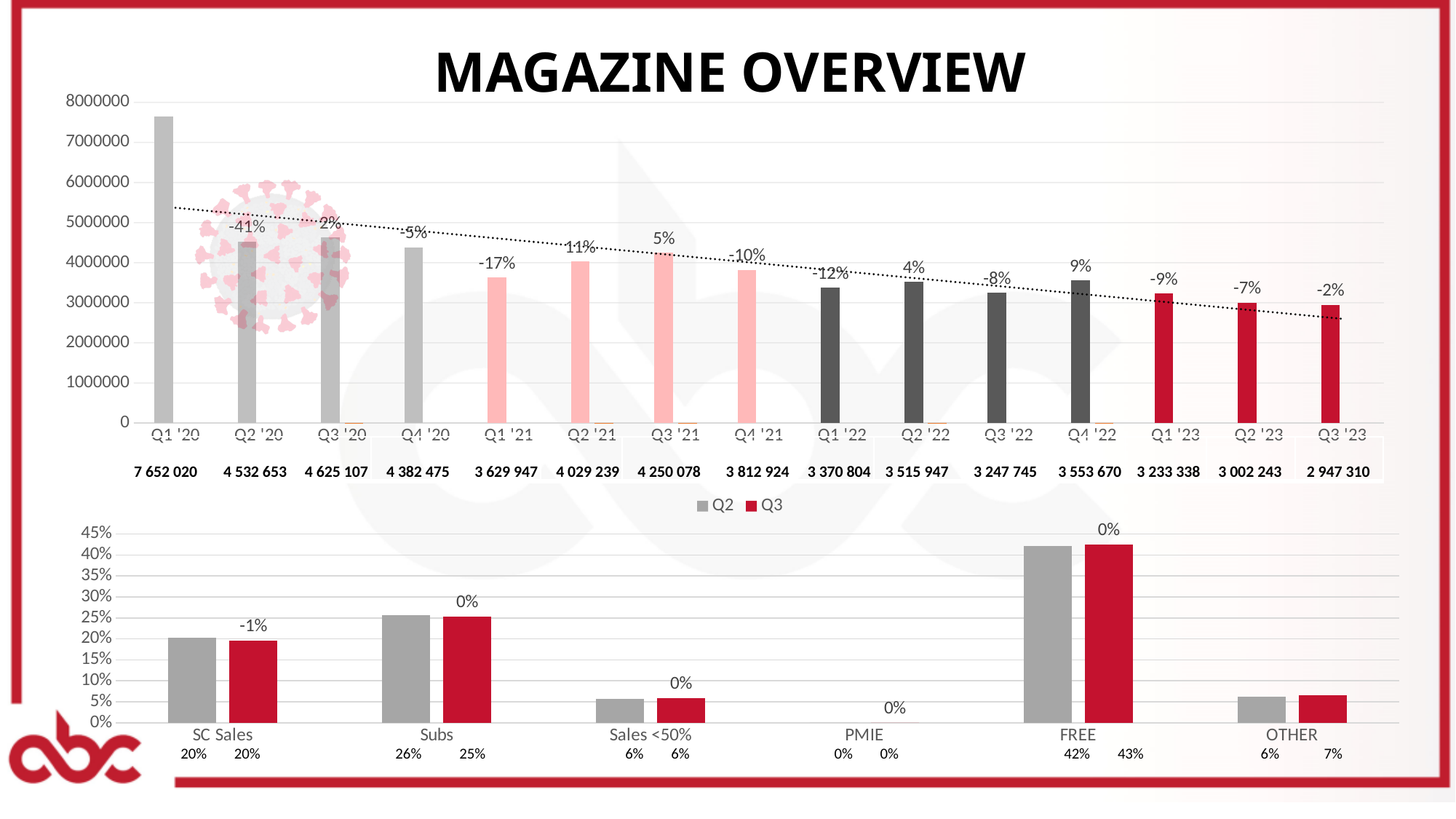
In the top chart, which quarter has the highest value? Q1 '20 In the bottom chart, what is the Q3 value for FREE? 43% In the bottom chart, which category has the highest Q2 value? FREE In the top chart, what is the value for Q1 '20? 7 652 020 In the top chart, do the values generally rise or fall from Q1 '20 to Q3 '23? fall In the top chart, what is the value for Q3 '23? 2 947 310 In the bottom chart, what is the Q2 value for Subs? 26% In the top chart, what is the difference between the values for Q1 '20 and Q2 '20? 3 119 367 In the top chart, which is larger, the value for Q2 '21 or the value for Q4 '21? Q2 '21 In the top chart, how many quarters are plotted? 15 In the top chart, which quarter has the lowest value? Q3 '23 In the bottom chart, how many series does the legend list? 2